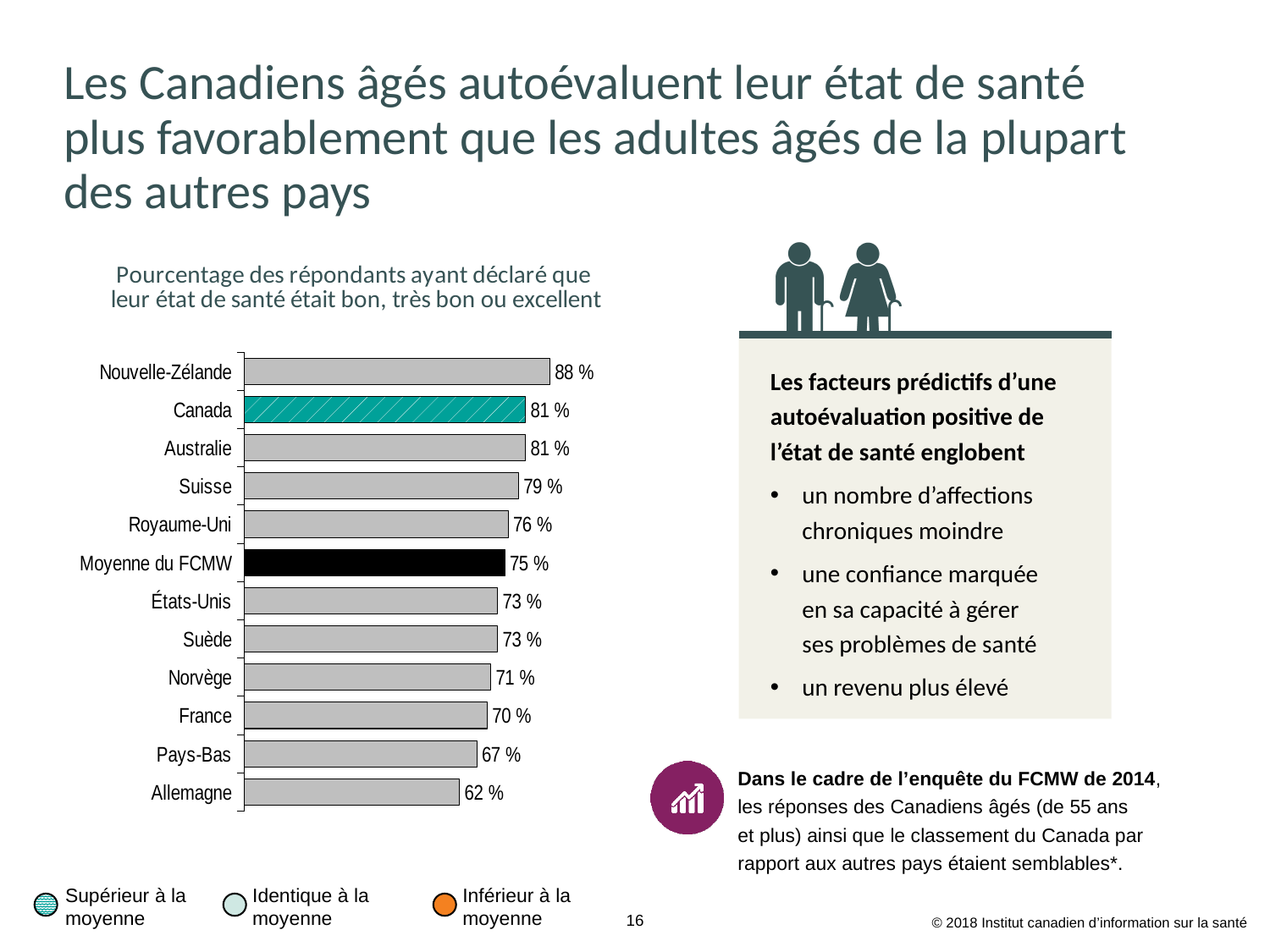
Which is larger, the value for Royaume-Uni or the value for France? Royaume-Uni What kind of chart is shown on the slide? Bar chart What value is shown for Moyenne du FCMW? 75 % Which country has the highest value? Nouvelle-Zélande What is the difference between the values for Canada and Moyenne du FCMW? 6 % Which country has the lowest value? Allemagne What value is shown for Suisse? 79 % What value is shown for Allemagne? 62 % How many bars are shown in the chart? 12 What is the title of the chart? Pourcentage des répondants ayant déclaré que leur état de santé était bon, très bon ou excellent What is the difference between the values for Nouvelle-Zélande and Canada? 7 % What value is shown for Canada? 81 %